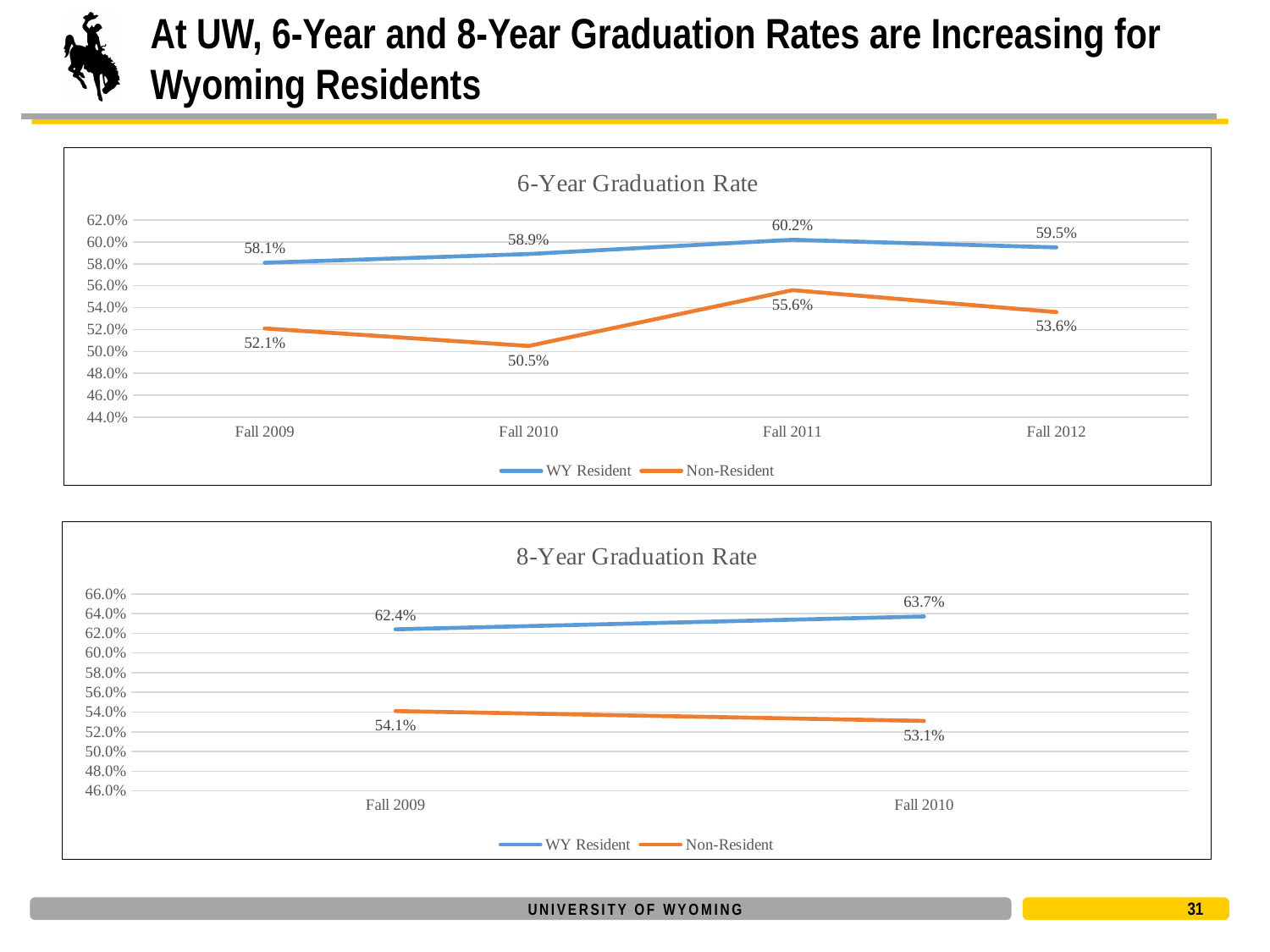
In the 8-Year Graduation Rate chart, what is the Non-Resident value for Fall 2009? 54.1% In the 6-Year Graduation Rate chart, what type of chart is used? Line chart In the 6-Year Graduation Rate chart, what is the WY Resident value for Fall 2011? 60.2% In the 8-Year Graduation Rate chart, does the Non-Resident rate rise or fall from Fall 2009 to Fall 2010? Fall In the 6-Year Graduation Rate chart, what is the difference between the WY Resident and Non-Resident rates for Fall 2012? 5.9% In the 6-Year Graduation Rate chart, how many cohorts are shown on the x axis? 4 In the 6-Year Graduation Rate chart, what is the Non-Resident value for Fall 2010? 50.5% In the 8-Year Graduation Rate chart, what is the WY Resident value for Fall 2010? 63.7% In the 8-Year Graduation Rate chart, what is the difference between the WY Resident rates for Fall 2010 and Fall 2009? 1.3% In the 6-Year Graduation Rate chart, which cohort has the highest WY Resident rate? Fall 2011 In the 8-Year Graduation Rate chart, how many series does the legend list? 2 In the 6-Year Graduation Rate chart, which cohort has the lowest Non-Resident rate? Fall 2010